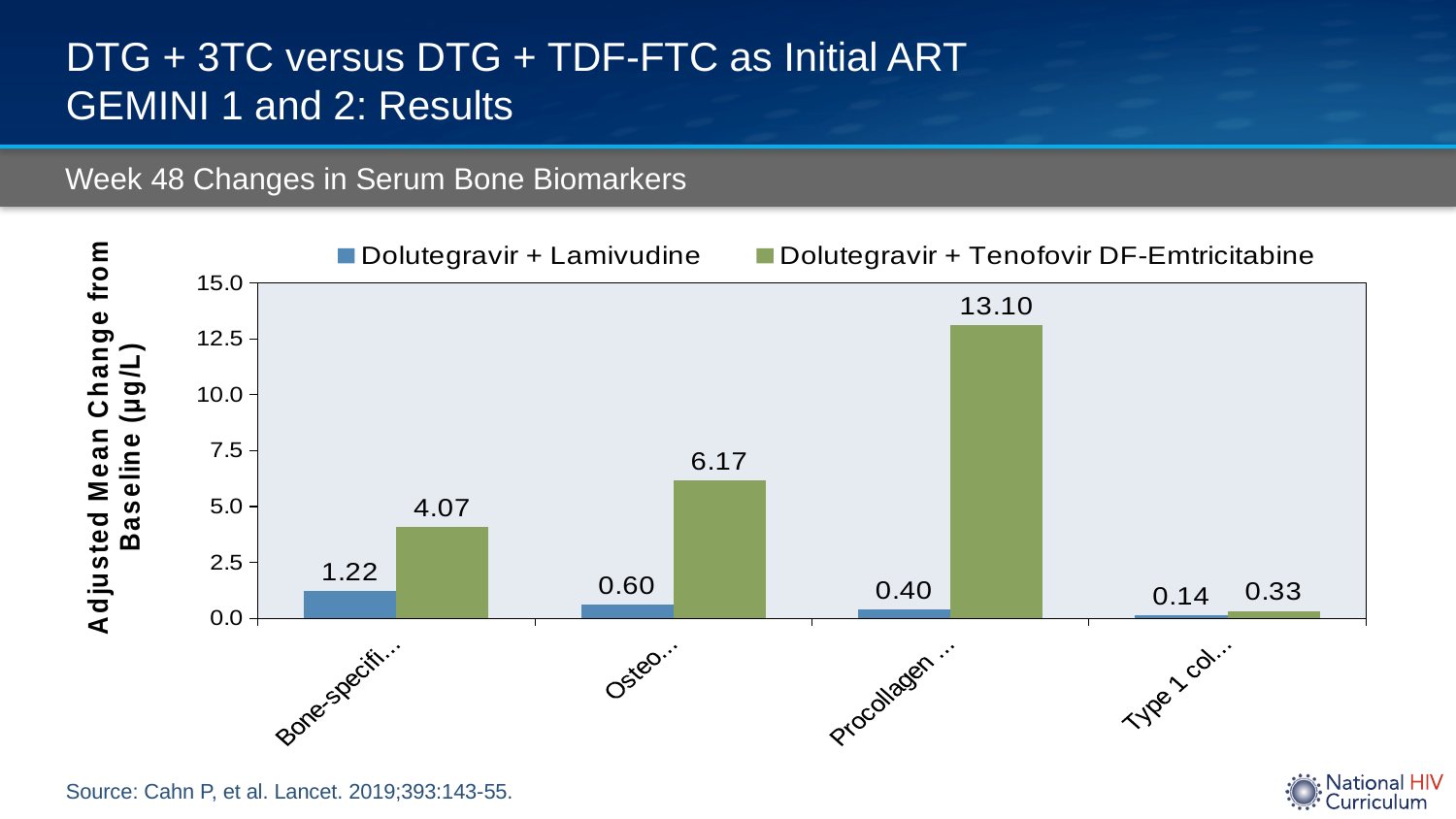
What is the value for Dolutegravir + Lamivudine in the fourth category (labelled "Type 1 col...")? 0.14 What is the difference between the Dolutegravir + Tenofovir DF-Emtricitabine and Dolutegravir + Lamivudine values in the first category (labelled "Bone-specifi...")? 2.85 In which category does Dolutegravir + Lamivudine have its lowest value? Type 1 col... (fourth category) What is the value for Dolutegravir + Lamivudine in the first category (labelled "Bone-specifi...")? 1.22 What is the value for Dolutegravir + Tenofovir DF-Emtricitabine in the second category (labelled "Osteo...")? 6.17 What is the adjusted mean change from baseline for Dolutegravir + Tenofovir DF-Emtricitabine in the third category (labelled "Procollagen ...")? 13.10 How many series does the legend list? 2 How many categories are shown on the x axis? 4 In which category does Dolutegravir + Tenofovir DF-Emtricitabine have its highest value? Procollagen ... (third category) In the second category (labelled "Osteo..."), which series has the larger value? Dolutegravir + Tenofovir DF-Emtricitabine Is the Dolutegravir + Tenofovir DF-Emtricitabine value in the third category (labelled "Procollagen ...") greater or less than 12.5? greater What type of chart is shown on the slide? Bar chart